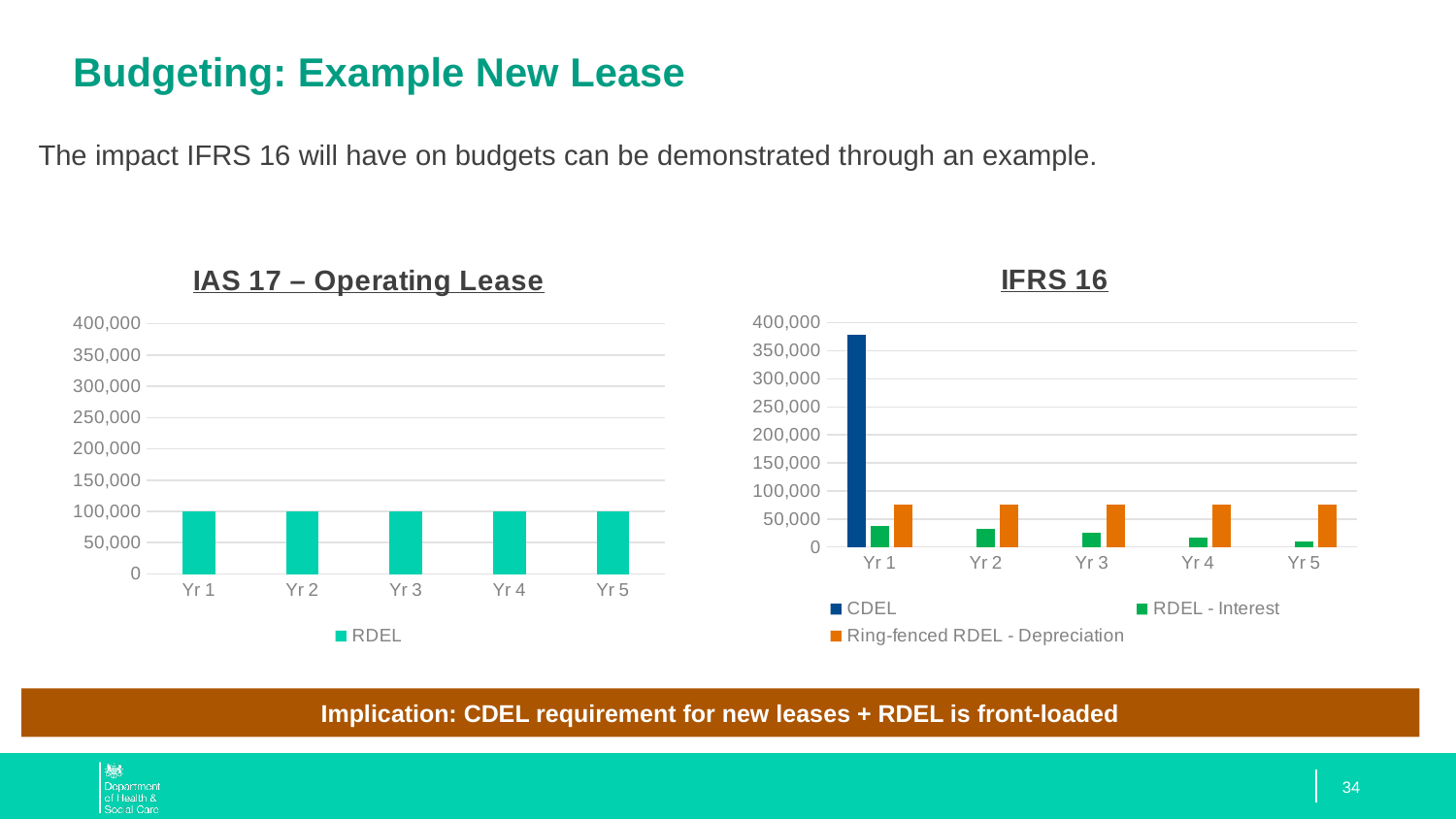
What kind of chart is the IAS 17 – Operating Lease chart? bar chart In the IFRS 16 chart, is the CDEL value for Yr 1 greater or less than 350,000? greater In the IFRS 16 chart, do the RDEL - Interest values rise or fall from Yr 1 to Yr 5? fall In the IAS 17 – Operating Lease chart, do the RDEL values rise, fall or stay flat from Yr 1 to Yr 5? stay flat In the IFRS 16 chart, which is larger in Yr 2: RDEL - Interest or Ring-fenced RDEL - Depreciation? Ring-fenced RDEL - Depreciation How many series does the legend of the IFRS 16 chart list? 3 In the IFRS 16 chart, which colour represents CDEL? dark blue How many categories are shown on the x axis of the IAS 17 – Operating Lease chart? 5 In the IAS 17 – Operating Lease chart, what is the RDEL value for Yr 3? 100,000 How many series does the legend of the IAS 17 – Operating Lease chart list? 1 In the IFRS 16 chart, is the RDEL - Interest value for Yr 1 greater or less than 50,000? less In the IFRS 16 chart, which year has the highest CDEL value? Yr 1